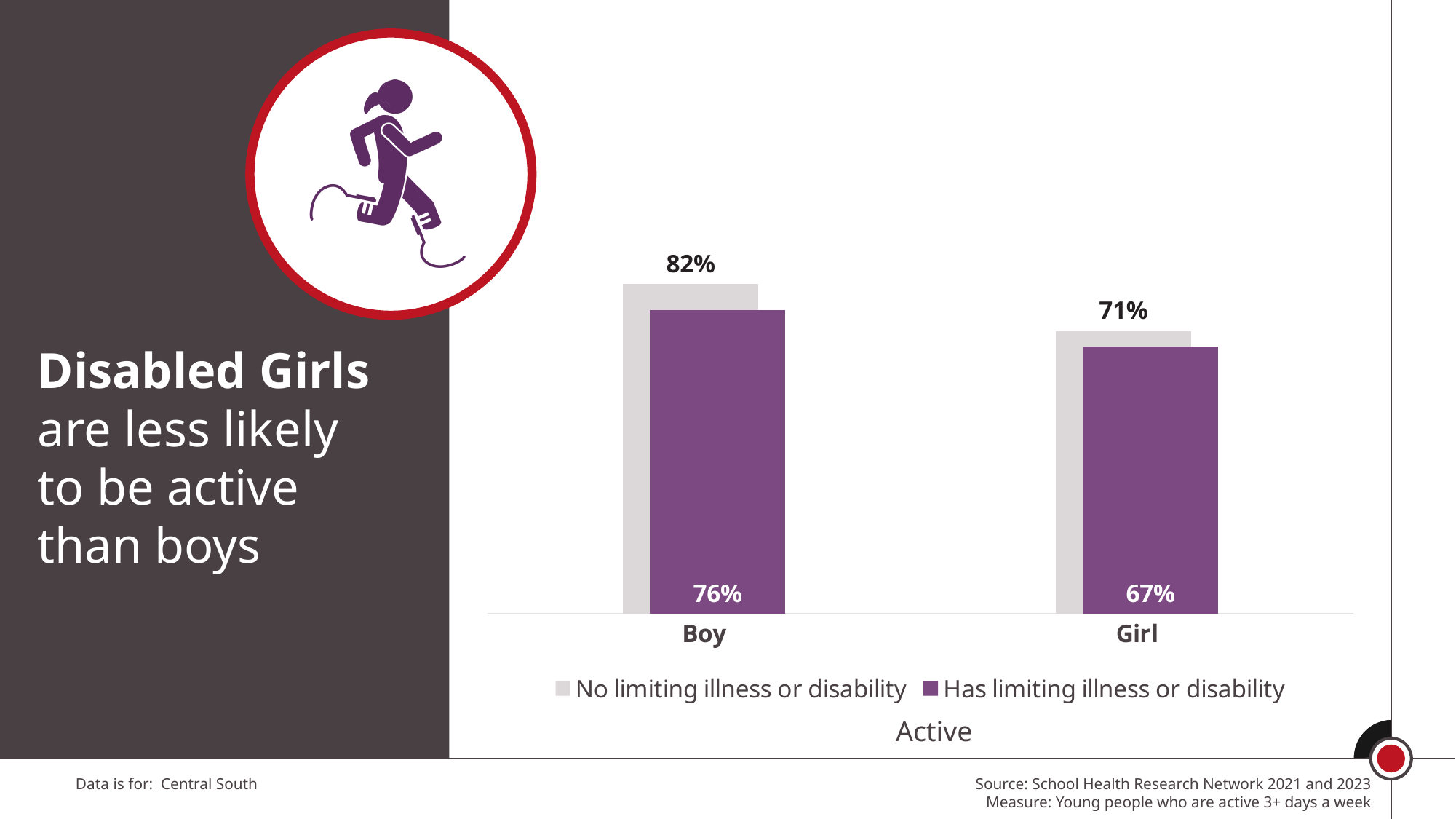
Which is larger: the 'Has limiting illness or disability' value for Boy or the 'No limiting illness or disability' value for Girl? Boy, Has limiting illness or disability How many series does the legend list? 2 What is the difference between the 'No limiting illness or disability' and 'Has limiting illness or disability' values for Girl? 4% What is the value for Girl in the 'No limiting illness or disability' series? 71% What is the value for Boy in the 'Has limiting illness or disability' series? 76% Which category has the highest value in the 'No limiting illness or disability' series? Boy How many categories are shown on the x axis? 2 What is the value for Boy in the 'No limiting illness or disability' series? 82% What is the difference between the Boy and Girl values in the 'Has limiting illness or disability' series? 9% Which category has the lowest value in the 'Has limiting illness or disability' series? Girl What is the value for Girl in the 'Has limiting illness or disability' series? 67% What kind of chart is shown on the slide? Bar chart